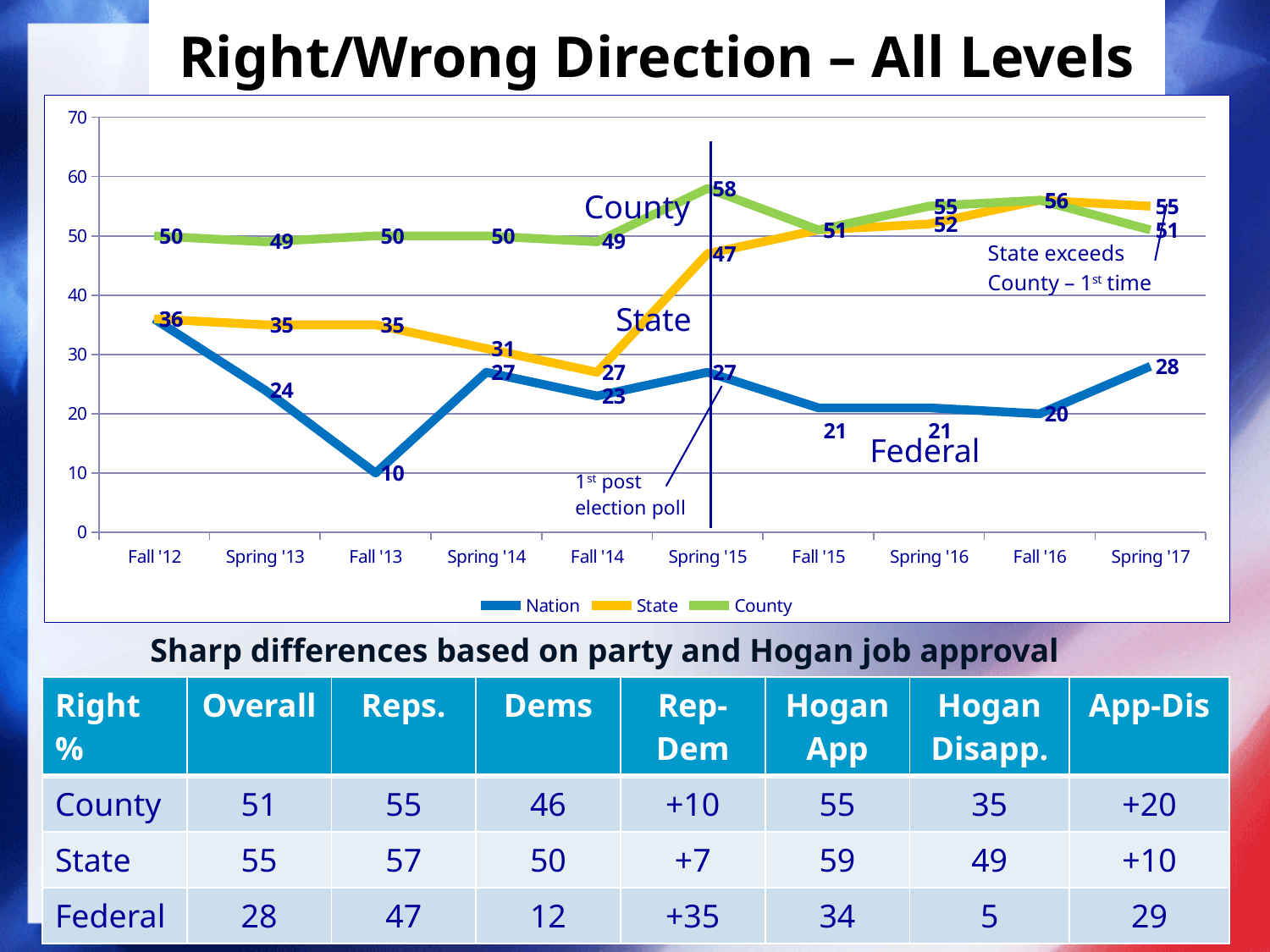
What is the County value in Spring '15? 58 In which period does the County series reach its highest value? Spring '15 Does the State series rise or fall from Fall '14 to Fall '16? rise In which period is the Nation series at its lowest? Fall '13 Which series is drawn in green in the chart? County In Spring '17, which is higher, the State value or the County value? State What is the Nation value in Fall '13? 10 How many series does the chart legend list? 3 How many survey periods are shown along the x axis of the chart? 10 What kind of chart is shown on the slide? line chart What is the State value in Spring '16? 52 What is the difference between the County and Nation values in Spring '15? 31